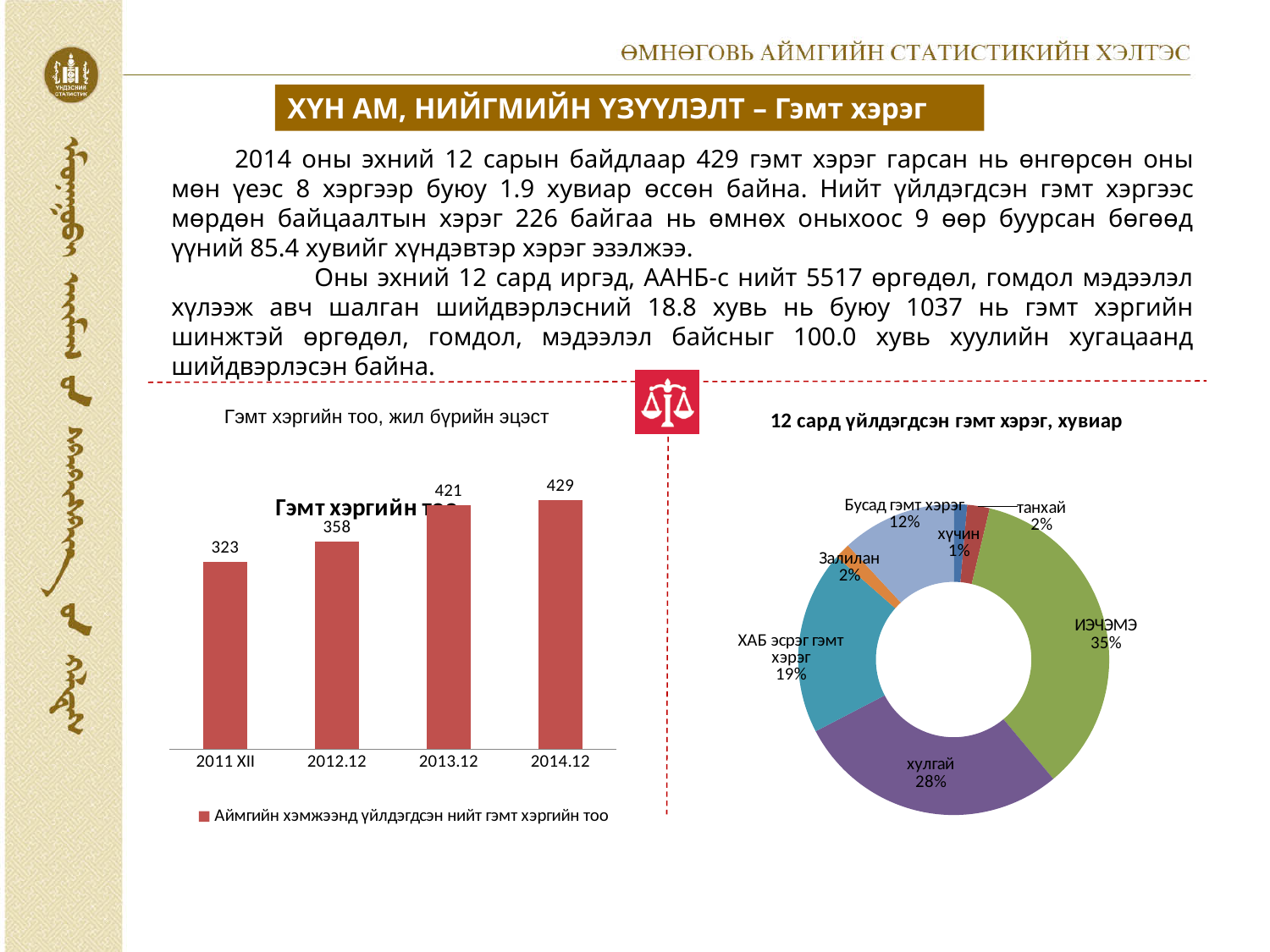
In the bar chart 'Гэмт хэргийн тоо, жил бүрийн эцэст', how many periods are shown on the x axis? 4 What is the legend entry shown below the bar chart 'Гэмт хэргийн тоо, жил бүрийн эцэст'? Аймгийн хэмжээнд үйлдэгдсэн нийт гэмт хэргийн тоо In the bar chart 'Гэмт хэргийн тоо, жил бүрийн эцэст', what is the difference between the values for 2013.12 and 2012.12? 63 In the bar chart 'Гэмт хэргийн тоо, жил бүрийн эцэст', do the values rise or fall from 2011 XII to 2014.12? rise In the bar chart 'Гэмт хэргийн тоо, жил бүрийн эцэст', what is the value for 2014.12? 429 In the bar chart 'Гэмт хэргийн тоо, жил бүрийн эцэст', what is the value for 2011 XII? 323 What kind of chart is the left chart 'Гэмт хэргийн тоо, жил бүрийн эцэст'? bar chart In the bar chart 'Гэмт хэргийн тоо, жил бүрийн эцэст', which period has the highest value? 2014.12 In the doughnut chart '12 сард үйлдэгдсэн гэмт хэрэг, хувиар', what share does 'хулгай' have? 28% In the doughnut chart '12 сард үйлдэгдсэн гэмт хэрэг, хувиар', which category has the largest share? ИЭЧЭМЭ In the bar chart 'Гэмт хэргийн тоо, жил бүрийн эцэст', which period has the lowest value? 2011 XII In the doughnut chart '12 сард үйлдэгдсэн гэмт хэрэг, хувиар', which is larger: 'ХАБ эсрэг гэмт хэрэг' or 'Бусад гэмт хэрэг'? ХАБ эсрэг гэмт хэрэг